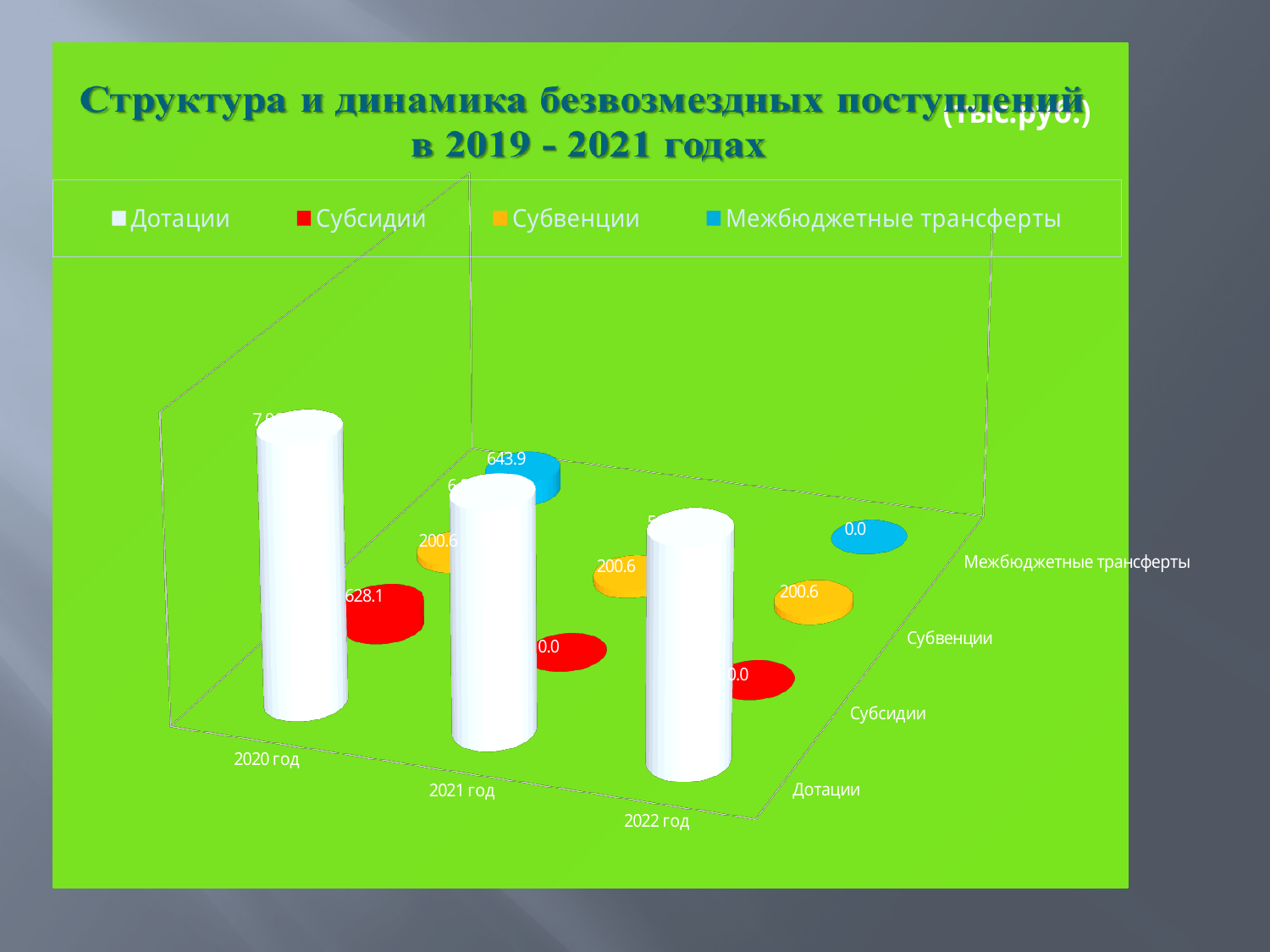
What is the difference between Субсидии and Субвенции in 2020 год? 427.5 What is the value for Межбюджетные трансферты in 2022 год? 0.0 How many series does the legend list? 4 How many year categories are plotted along the x axis? 3 What kind of chart is shown on the slide? bar chart Which colour represents Субсидии in the legend? red What is the value for Субвенции in 2020 год? 200.6 Which is larger in 2020 год, Субсидии or Субвенции? Субсидии What is the value for Субвенции in 2022 год? 200.6 What is the value for Субсидии in 2020 год? 628.1 Do the values for Субвенции rise, fall or stay the same from 2020 год to 2022 год? stay the same